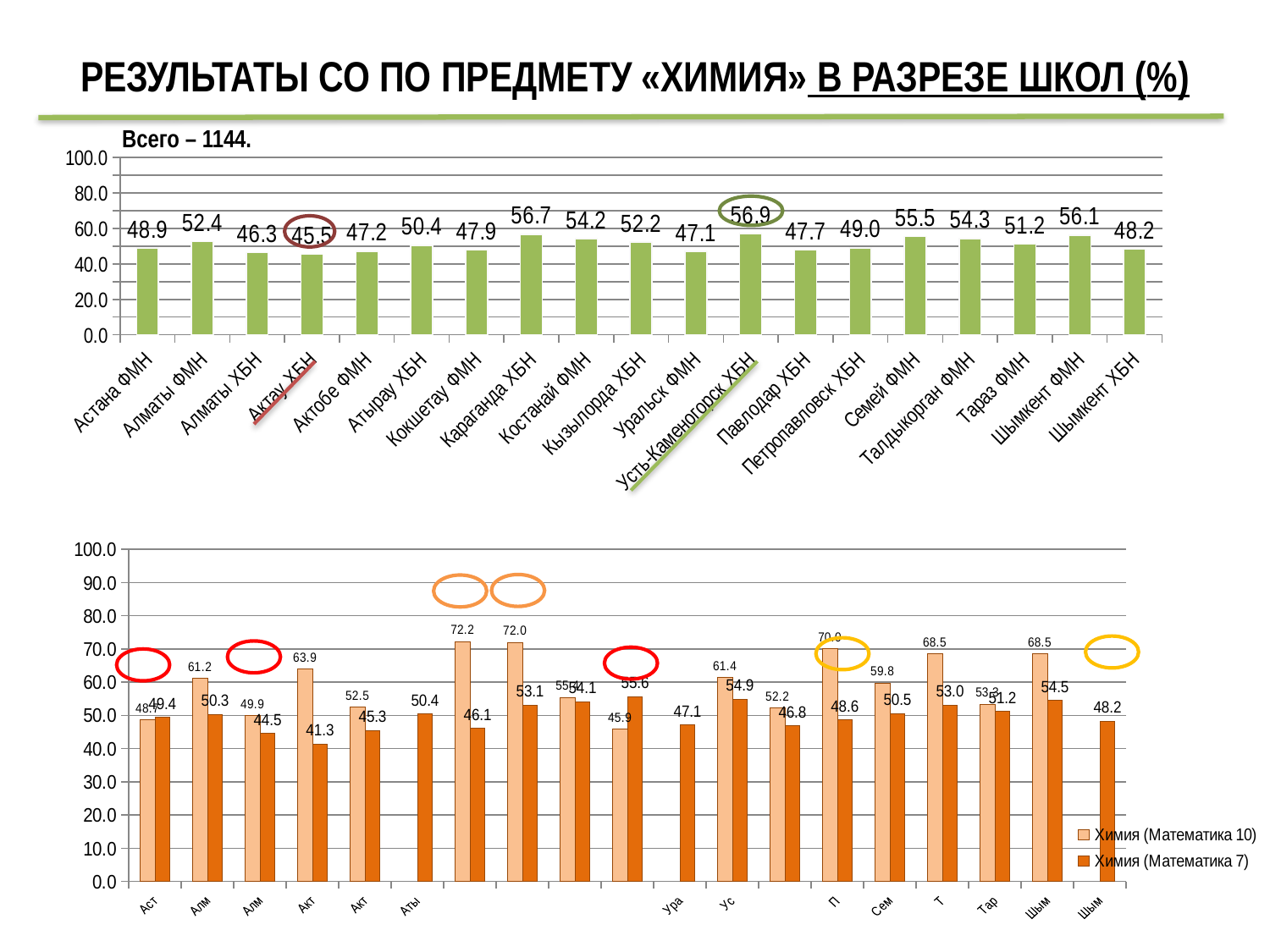
In the top chart, which school has the highest value? Усть-Каменогорск ХБН In the bottom chart, what is the value of Химия (Математика 7) for Сем? 50.5 In the bottom chart, what is the value of Химия (Математика 10) for Ус? 61.4 In the top chart, what is the value for Усть-Каменогорск ХБН? 56.9 In the top chart, which is larger: the value for Семей ФМН or the value for Талдыкорган ФМН? Семей ФМН In the top chart, which school has the lowest value? Актау ХБН In the top chart, how many schools are shown? 19 In the bottom chart, how many series does the legend list? 2 In the top chart, what is the difference between the values for Шымкент ФМН and Шымкент ХБН? 7.9 What kind of chart is the top chart? bar chart In the top chart, is the value for Алматы ХБН greater or less than 60? less In the top chart, what is the value for Караганда ХБН? 56.7